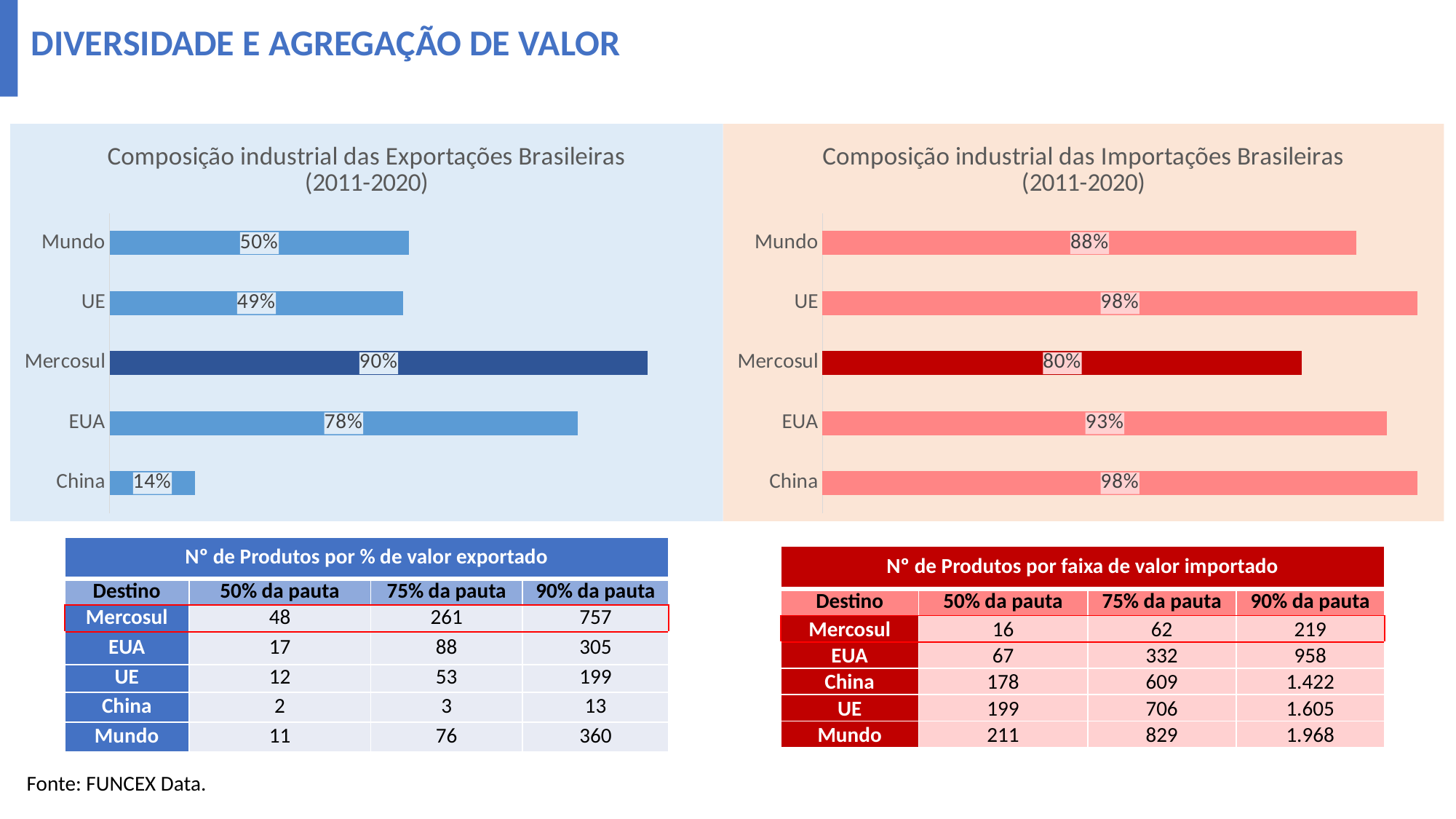
What kind of chart is 'Composição industrial das Exportações Brasileiras (2011-2020)'? Bar chart In the chart 'Composição industrial das Importações Brasileiras (2011-2020)', what is the value for Mercosul? 80% In the chart 'Composição industrial das Exportações Brasileiras (2011-2020)', what is the value for China? 14% In the chart 'Composição industrial das Exportações Brasileiras (2011-2020)', which category has the lowest value? China In the chart 'Composição industrial das Exportações Brasileiras (2011-2020)', which is larger, the value for Mundo or the value for UE? Mundo In the chart 'Composição industrial das Exportações Brasileiras (2011-2020)', which category has the highest value? Mercosul In the chart 'Composição industrial das Importações Brasileiras (2011-2020)', what is the value for Mundo? 88% In the chart 'Composição industrial das Importações Brasileiras (2011-2020)', which category has the lowest value? Mercosul How many categories are shown in the chart 'Composição industrial das Importações Brasileiras (2011-2020)'? 5 In the chart 'Composição industrial das Exportações Brasileiras (2011-2020)', what is the difference between the values for Mercosul and EUA? 12% In the chart 'Composição industrial das Exportações Brasileiras (2011-2020)', what is the value for Mercosul? 90% In the chart 'Composição industrial das Importações Brasileiras (2011-2020)', what is the difference between the values for EUA and Mercosul? 13%